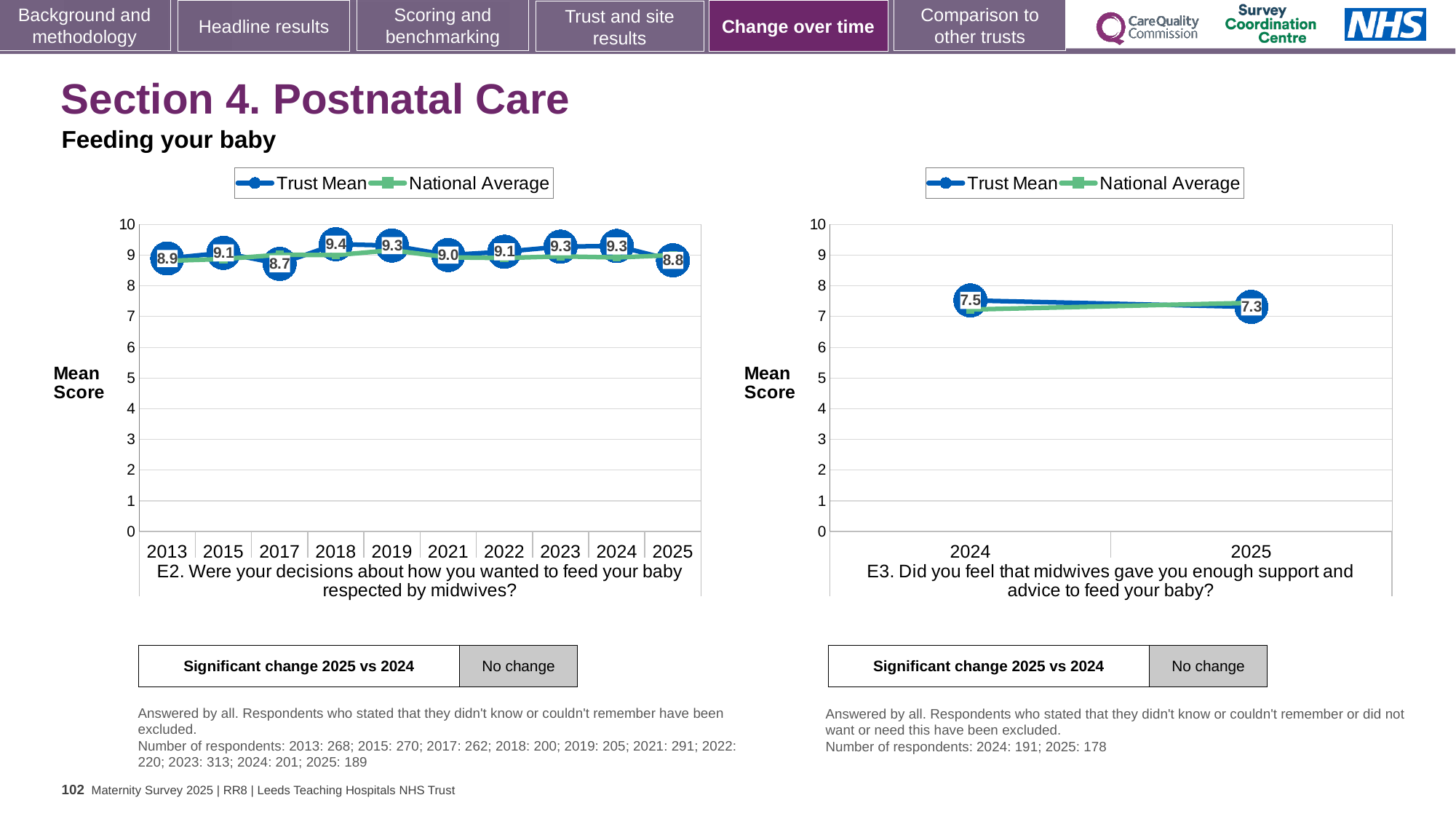
On the right chart (E3), does the Trust Mean rise or fall from 2024 to 2025? fall How many series does the legend of the left chart (E2) list? 2 What kind of chart is the right chart (E3)? line chart On the left chart (E2), in which year is the Trust Mean lowest? 2017 On the left chart (E2), what is the Trust Mean score for 2018? 9.4 On the left chart (E2), what is the difference between the Trust Mean in 2018 and in 2017? 0.7 On the right chart (E3), what is the Trust Mean score for 2024? 7.5 On the right chart (E3), what is the Trust Mean score for 2025? 7.3 On the left chart (E2), how many years are plotted on the x axis? 10 On the left chart (E2), in which year is the Trust Mean highest? 2018 On the left chart (E2), what is the Trust Mean score for 2025? 8.8 On the right chart (E3), is the Trust Mean for 2025 greater or less than 8? less